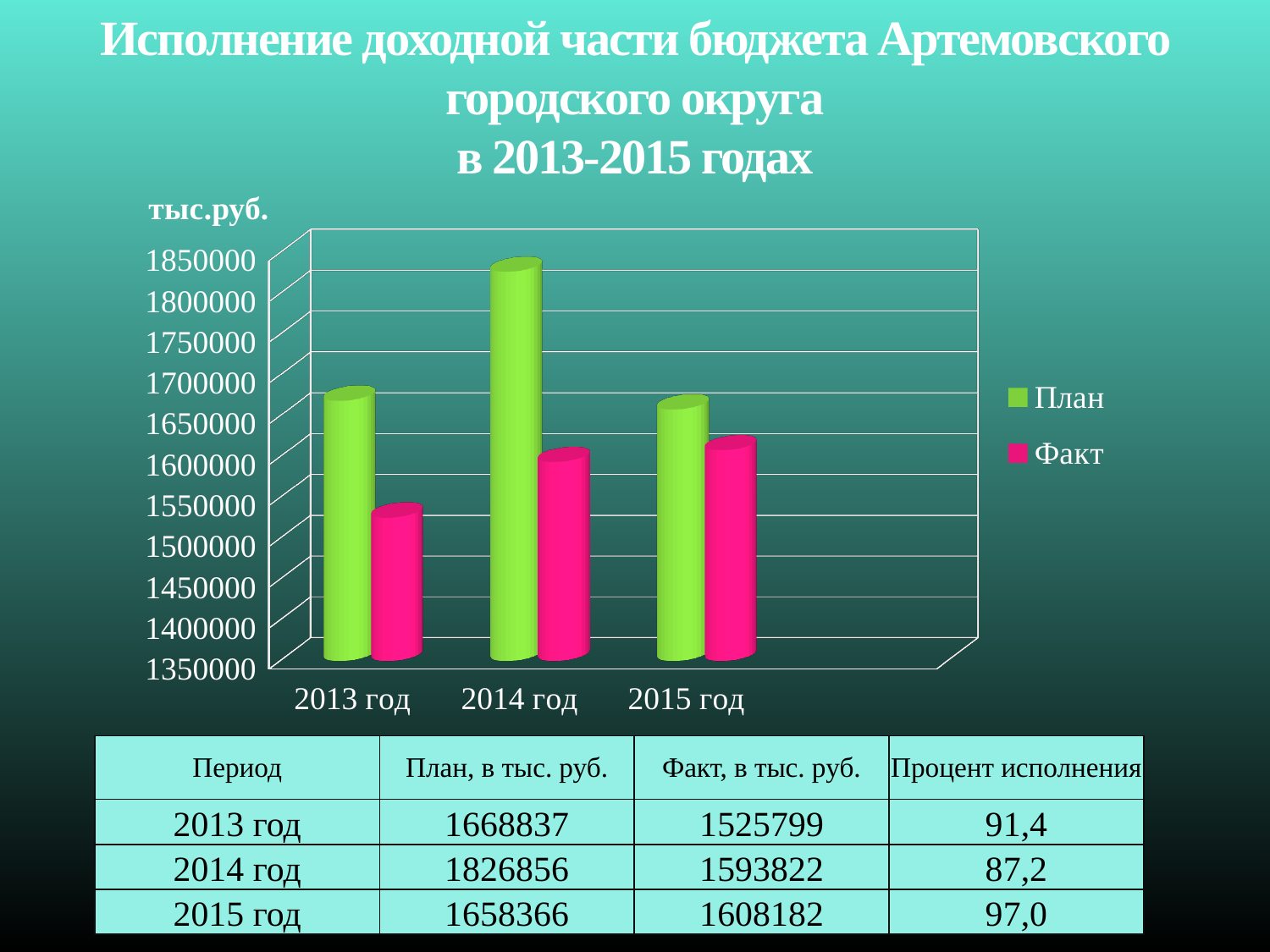
What is the Факт value for 2013 год, in тыс. руб.? 1525799 Is the Факт value for 2014 год greater or less than 1600000? less How many series does the chart legend list? 2 What is the План value for 2014 год, in тыс. руб.? 1826856 Which year has the lowest Факт value? 2013 год What are the two series named in the chart legend? План and Факт What kind of chart is shown on the slide? bar chart What is the Факт value for 2015 год, in тыс. руб.? 1608182 How many year categories are shown on the x axis of the chart? 3 Which is larger for 2013 год, the План value or the Факт value? План What is the difference between План and Факт for 2015 год, in тыс. руб.? 50184 Which year has the highest План value? 2014 год